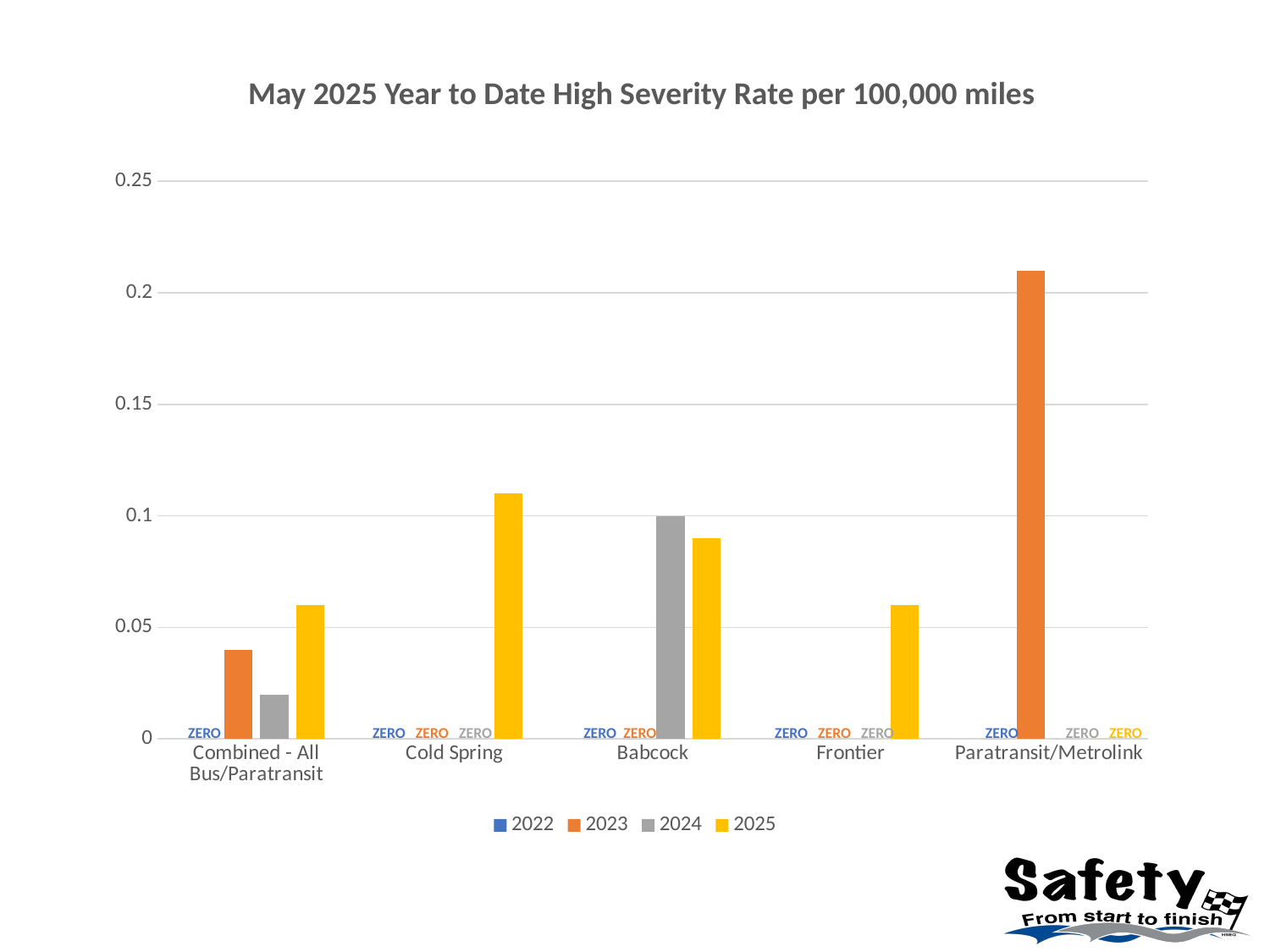
How many series does the legend list? 4 Which category contains the tallest bar in the chart? Paratransit/Metrolink Is the 2025 value for Combined - All Bus/Paratransit greater or less than 0.05? greater Which category has the highest 2025 value? Cold Spring For Combined - All Bus/Paratransit, which is larger: the 2023 value or the 2024 value? 2023 Is the 2025 value for Cold Spring greater or less than 0.1? greater What is the 2023 value for Cold Spring? ZERO What is the 2022 value for Frontier? ZERO What is the 2025 value for Paratransit/Metrolink? ZERO Is the 2023 value for Paratransit/Metrolink greater or less than 0.2? greater How many categories are shown on the x axis of the chart? 5 What kind of chart is shown on the slide? bar chart